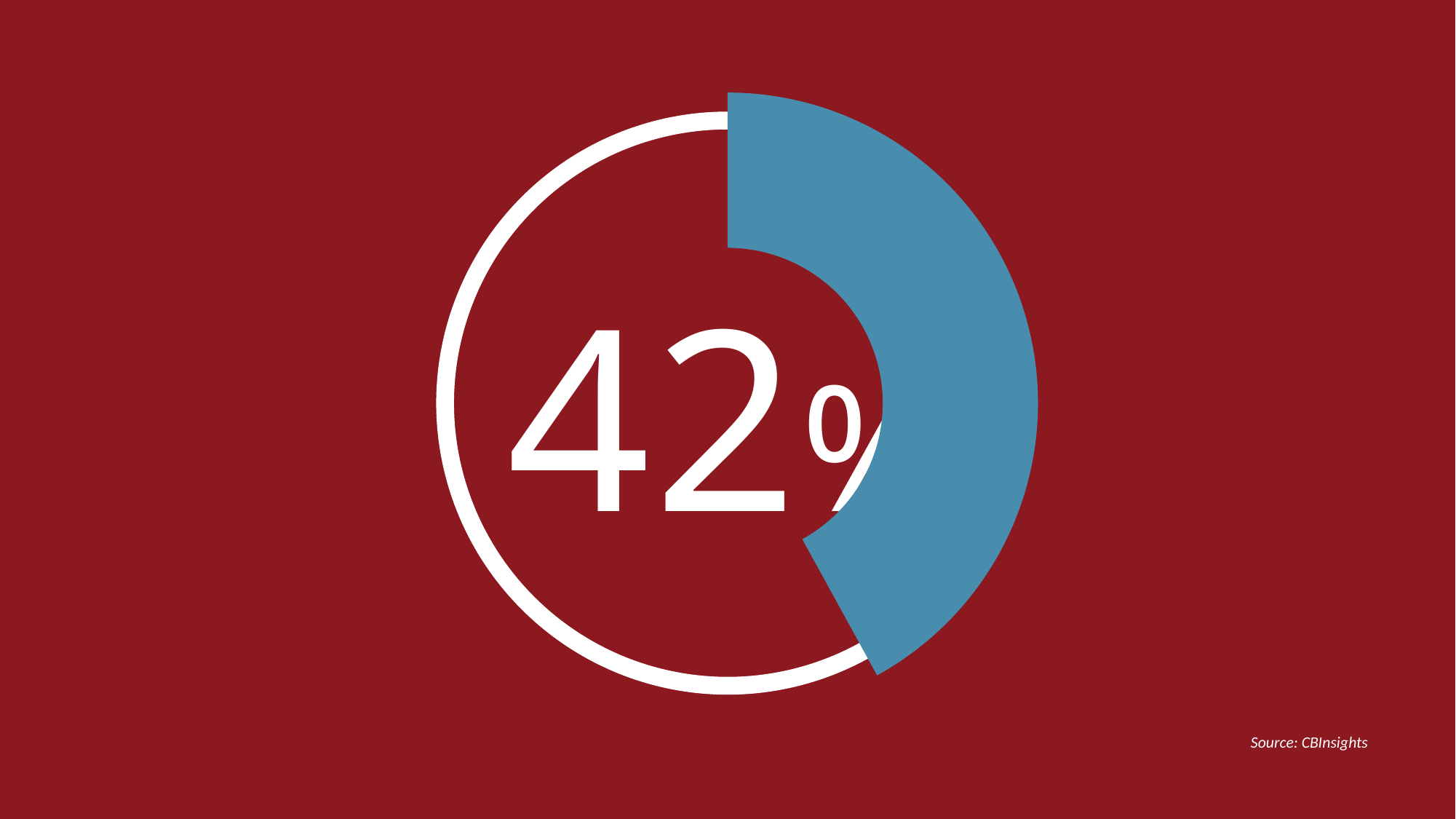
What source is cited for the chart on the slide? CBInsights What colour is the filled segment of the donut chart? blue What kind of chart is shown on the slide? donut chart What share of the ring does the blue filled segment represent? 42% What percentage is displayed in the centre of the donut chart? 42% Is the value shown in the donut chart greater or less than 40%? greater How many data values are labelled on the donut chart? 1 Is the value shown in the donut chart greater or less than 50%? less